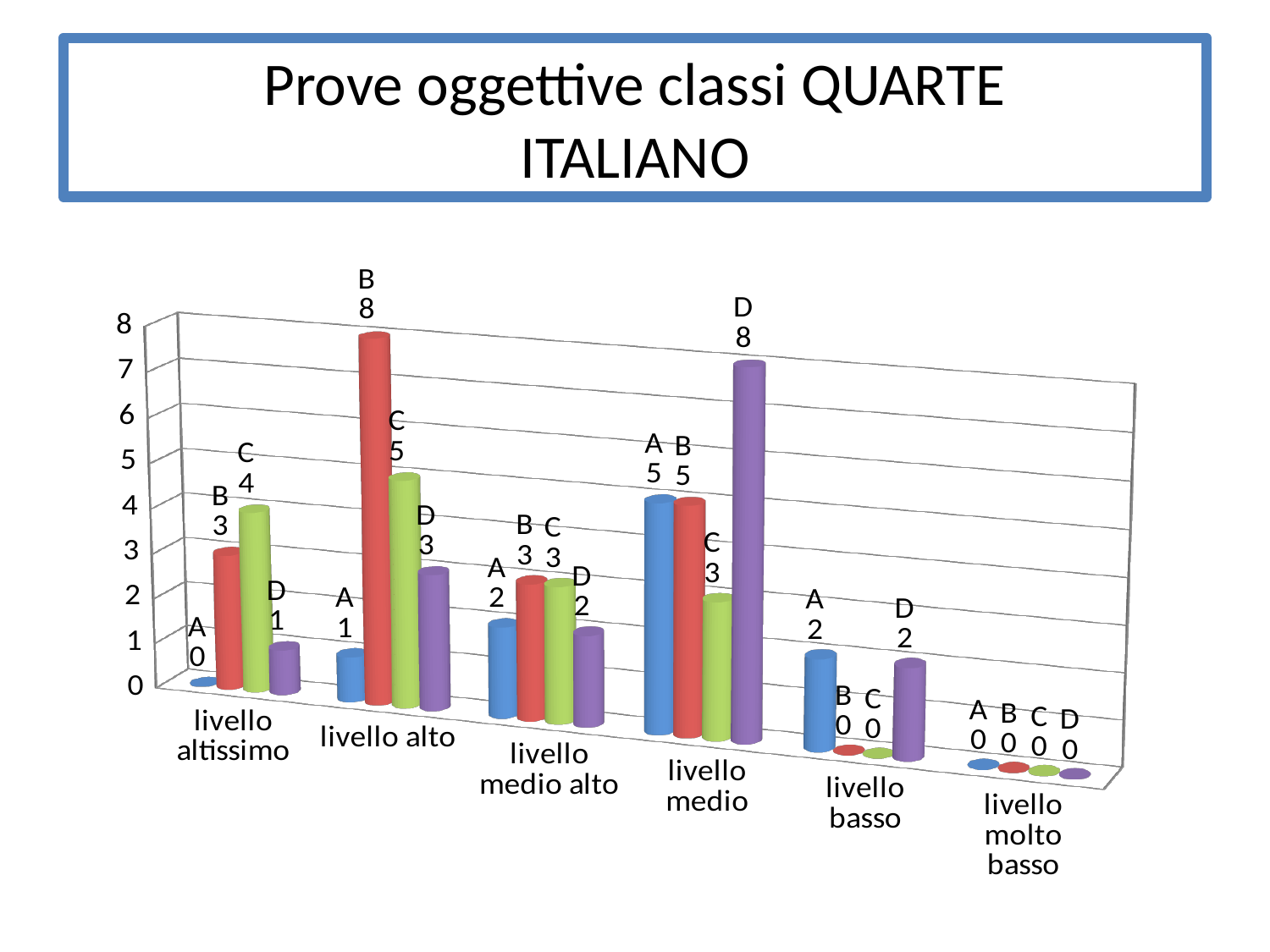
What is the value for series A at livello basso? 2 What is the title of the slide containing the chart? Prove oggettive classi QUARTE ITALIANO Which series has the lowest value at livello altissimo? A What is the total of the four series values at livello molto basso? 0 What kind of chart is shown on the slide? bar chart What is the value for series D at livello medio? 8 Which is larger at livello medio alto: series A or series B? B Which series has the highest value at livello medio? D What is the value for series C at livello altissimo? 4 How many categories (livelli) are shown on the x axis? 6 What is the value for series B at livello alto? 8 What is the difference between series B and series A at livello alto? 7